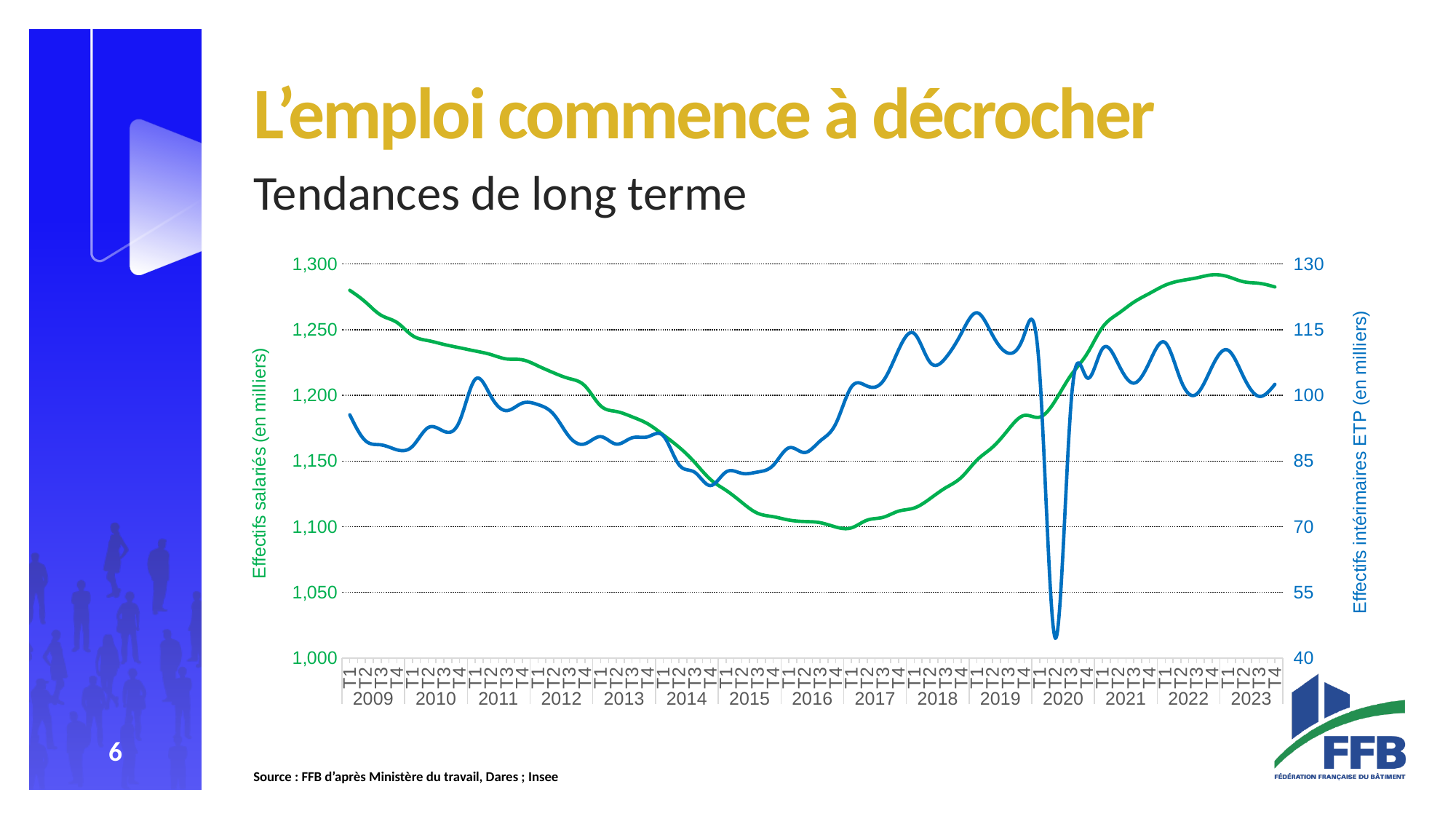
Is the value of Effectifs intérimaires ETP at T2 2020 greater or less than 55? less Is the value of Effectifs salariés at T1 2009 greater or less than 1,250? greater Is the value of Effectifs salariés at T1 2017 greater or less than 1,150? less How many years are labelled along the x axis? 15 What kind of chart is shown on the slide? line chart How many series are plotted on the chart? 2 What is the title of the left vertical axis? Effectifs salariés (en milliers) In which quarter does the Effectifs intérimaires ETP series reach its lowest value? T2 2020 What is the title of the right vertical axis? Effectifs intérimaires ETP (en milliers) Does the Effectifs salariés series rise or fall between 2009 and 2016? fall Which is larger for Effectifs salariés: the value at T1 2009 or the value at T1 2017? T1 2009 In which year does the Effectifs salariés series reach its lowest value? 2017